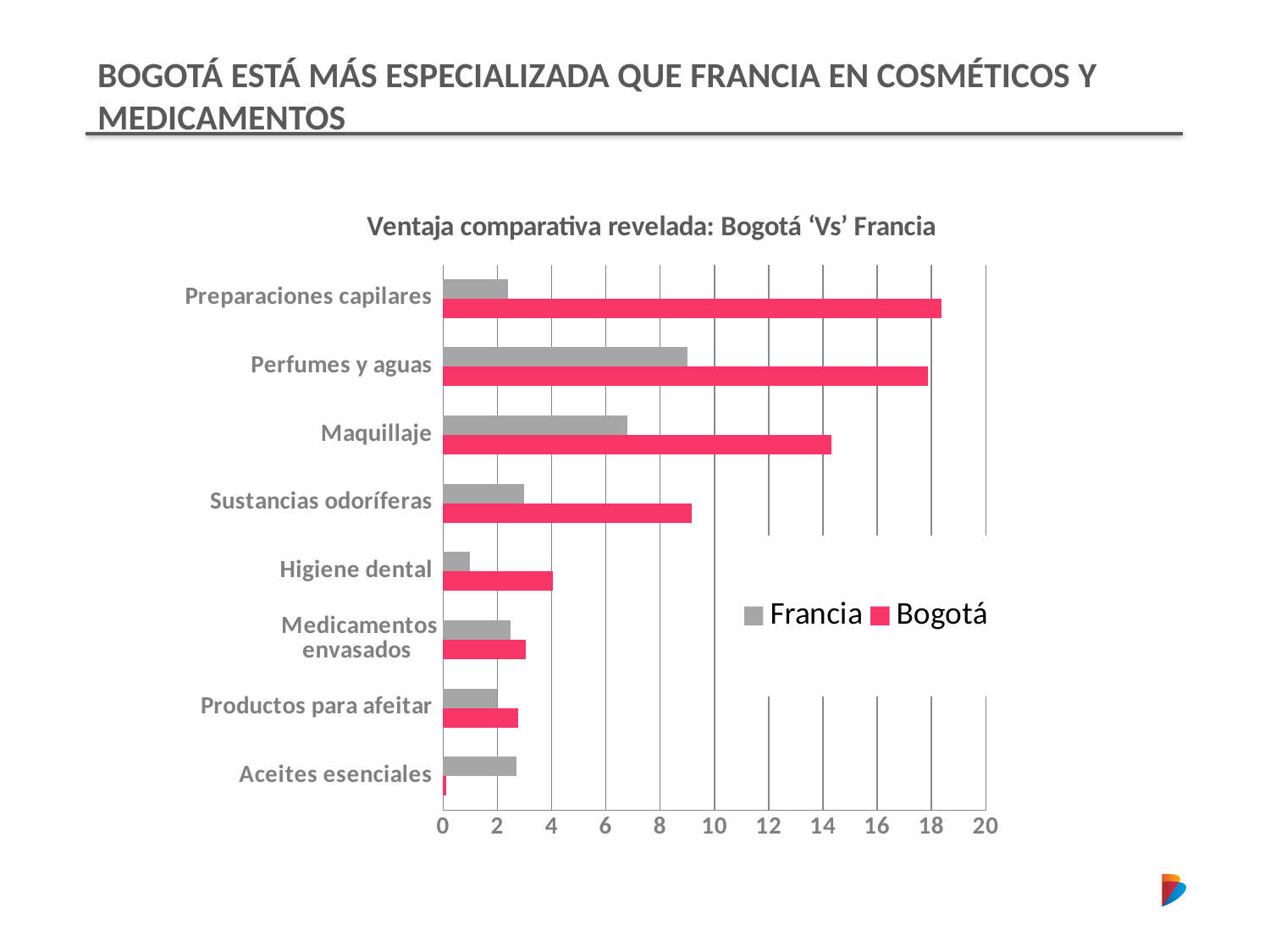
How many product categories are shown on the chart? 8 For Aceites esenciales, which series has the larger value, Francia or Bogotá? Francia Is the Bogotá value for Maquillaje greater or less than 12? greater Which category has the highest value for Francia? Perfumes y aguas Is the Bogotá value for Higiene dental greater or less than 6? less Which category has the lowest value for Francia? Higiene dental Is the Francia value for Perfumes y aguas greater or less than 10? less Which category has the lowest value for Bogotá? Aceites esenciales How many series does the legend list? 2 For Maquillaje, which series has the larger value, Francia or Bogotá? Bogotá What kind of chart is shown on the slide? bar chart What is the title of the chart? Ventaja comparativa revelada: Bogotá ‘Vs’ Francia